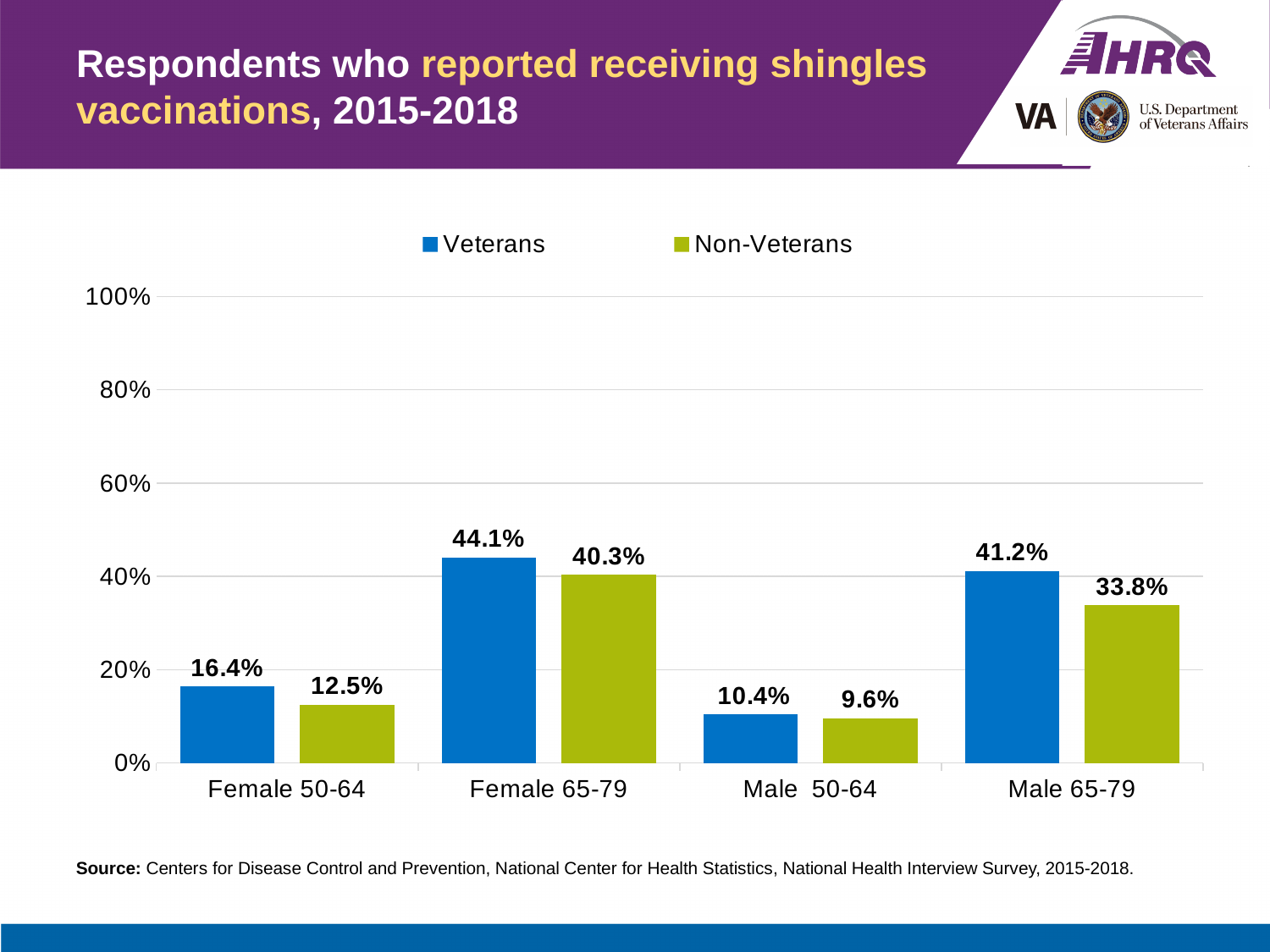
What is the difference between the Veterans and Non-Veterans values for Male 65-79? 7.4% What kind of chart is shown on the slide? Bar chart Which category has the highest value for Veterans? Female 65-79 How many categories are shown on the x axis? 4 Which category has the lowest value for Non-Veterans? Male 50-64 What is the value for Non-Veterans in the Male 50-64 category? 9.6% Which is larger for Female 50-64: the Veterans value or the Non-Veterans value? Veterans What percentage of Veterans aged Female 65-79 reported receiving shingles vaccinations? 44.1% What is the value for Non-Veterans in the Male 65-79 category? 33.8% What is the value for Veterans in the Female 50-64 category? 16.4% How many series does the legend list? 2 Is the value for Non-Veterans in the Female 65-79 category greater or less than 60%? less